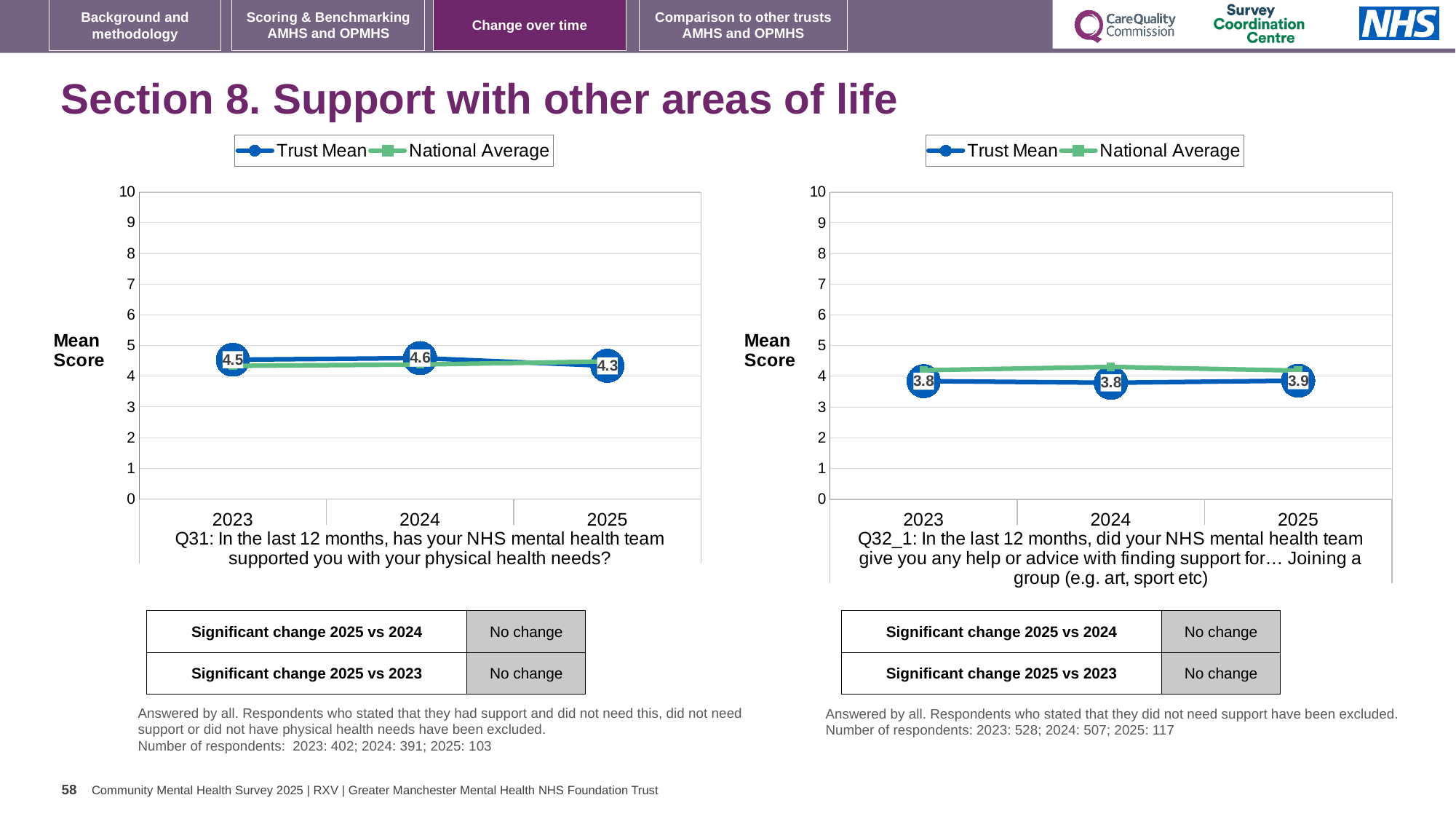
In the left chart (Q31), what is the Trust Mean for 2024? 4.6 In the right chart (Q32_1), what is the Trust Mean for 2025? 3.9 In the left chart (Q31), does the Trust Mean rise or fall from 2024 to 2025? fall In the left chart (Q31), what is the difference between the Trust Mean for 2024 and 2025? 0.3 What kind of chart is the left chart (Q31)? line chart In the left chart (Q31), which year has the lowest Trust Mean? 2025 In the left chart (Q31), which year has the highest Trust Mean? 2024 In the right chart (Q32_1), is the National Average for 2024 greater or less than 5? less How many series does the legend of the right chart (Q32_1) list? 2 How many years are plotted on the x axis of the left chart (Q31)? 3 In the right chart (Q32_1), which year has the highest Trust Mean? 2025 In the left chart (Q31), is the Trust Mean larger in 2023 or 2025? 2023